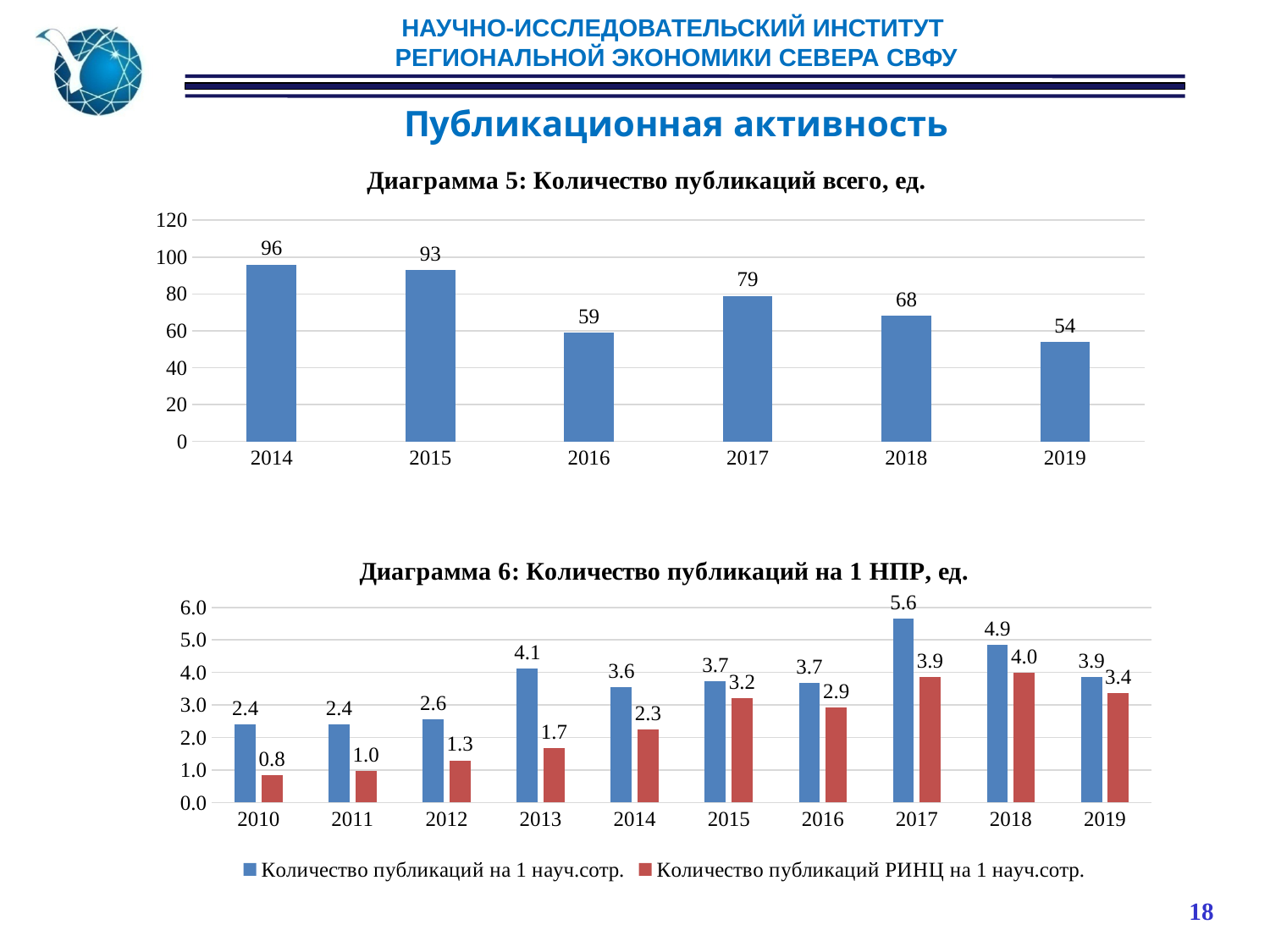
In Диаграмма 5 (Количество публикаций всего, ед.), what is the difference between the values for 2014 and 2019? 42 In Диаграмма 6 (Количество публикаций на 1 НПР, ед.), what is the value of Количество публикаций РИНЦ на 1 науч.сотр. for 2015? 3.2 In Диаграмма 6 (Количество публикаций на 1 НПР, ед.), which is larger in 2018: Количество публикаций на 1 науч.сотр. or Количество публикаций РИНЦ на 1 науч.сотр.? Количество публикаций на 1 науч.сотр. In Диаграмма 5 (Количество публикаций всего, ед.), how many years are shown on the x axis? 6 In Диаграмма 6 (Количество публикаций на 1 НПР, ед.), how many series does the legend list? 2 In Диаграмма 5 (Количество публикаций всего, ед.), which year has the highest value? 2014 In Диаграмма 5 (Количество публикаций всего, ед.), what is the value for 2017? 79 What kind of chart is Диаграмма 6 (Количество публикаций на 1 НПР, ед.)? Bar chart In Диаграмма 6 (Количество публикаций на 1 НПР, ед.), which year has the highest value of Количество публикаций на 1 науч.сотр.? 2017 In Диаграмма 5 (Количество публикаций всего, ед.), is the value for 2016 greater or less than 60? less In Диаграмма 6 (Количество публикаций на 1 НПР, ед.), which year has the lowest value of Количество публикаций РИНЦ на 1 науч.сотр.? 2010 In Диаграмма 5 (Количество публикаций всего, ед.), which year has the lowest value? 2019